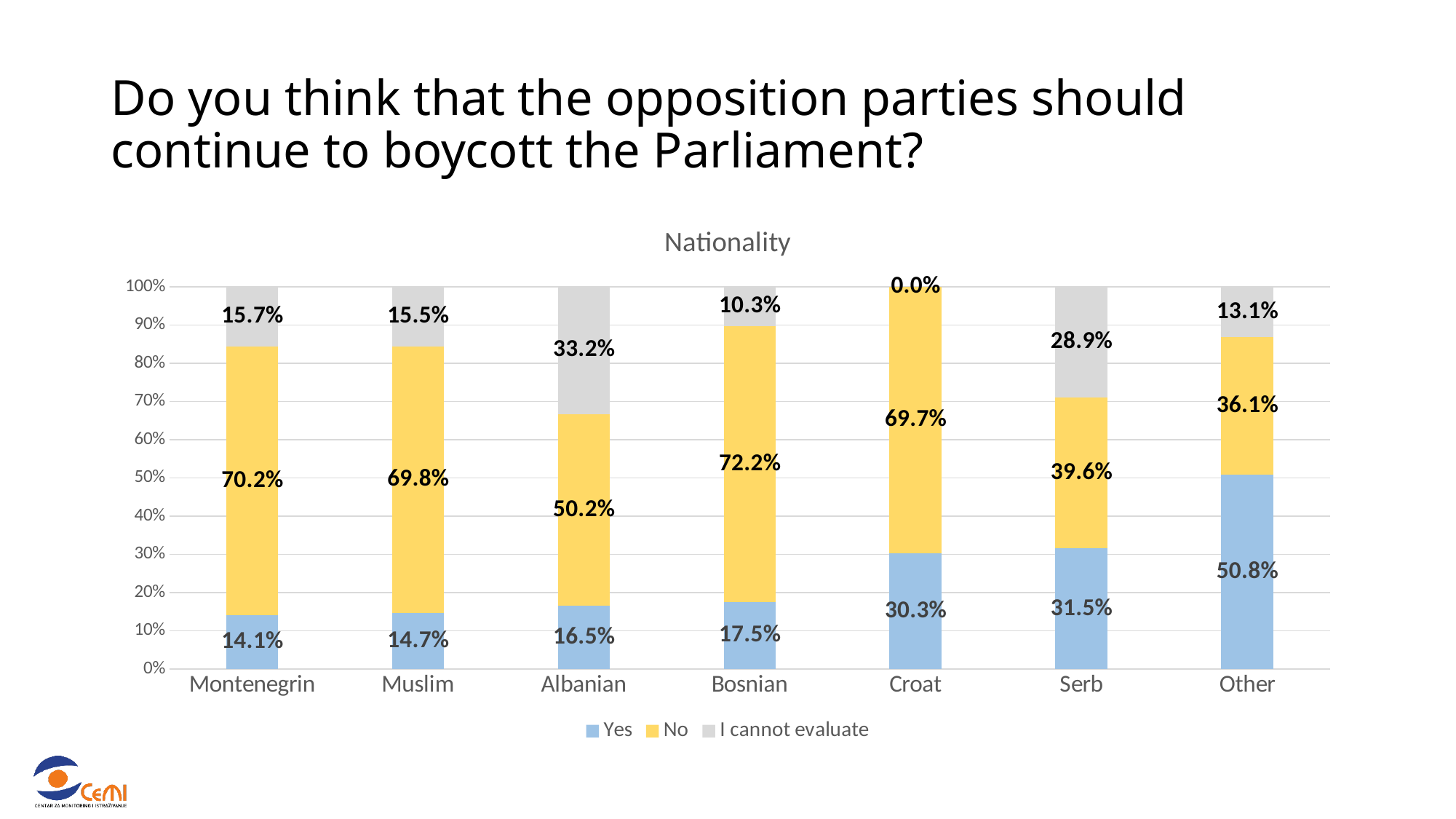
Which nationality has the highest "No" share? Bosnian What kind of chart is shown on the slide? Stacked bar chart What percentage of Montenegrin respondents answered "No"? 70.2% Which nationality has the lowest "Yes" share? Montenegrin How many series does the legend list? 3 What is the "I cannot evaluate" value for Albanian? 33.2% Which is larger, the "Yes" value for Serb or for Croat? Serb What is the difference between the "No" values for Bosnian and Serb? 32.6% Which nationality has the highest "Yes" share? Other What is the "Yes" value for Other? 50.8% What is the "I cannot evaluate" value for Croat? 0.0% How many nationality categories are shown on the x axis? 7